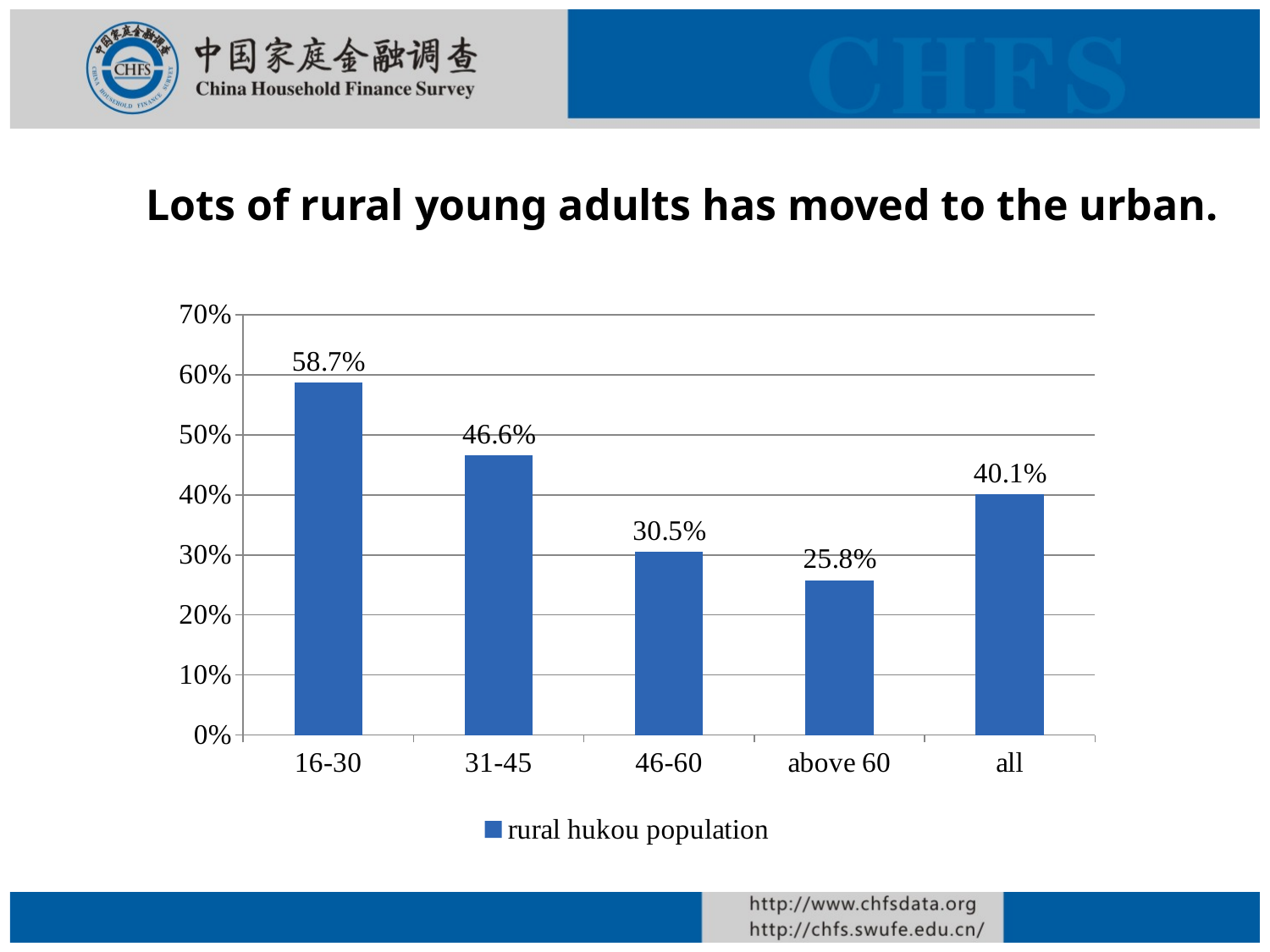
Which is larger, the value for 31-45 or the value for all? 31-45 Which category has the lowest value? above 60 What is the value for the 'all' category? 40.1% Which category has the highest value? 16-30 What is the value for the 16-30 age group? 58.7% How many categories are shown on the x axis? 5 What is the difference between the values for 16-30 and 46-60? 28.2% What series name does the legend show? rural hukou population What is the value for the above 60 age group? 25.8% What is the value for the 31-45 age group? 46.6% Is the value for 46-60 greater or less than 40%? less What kind of chart is shown on the slide? bar chart